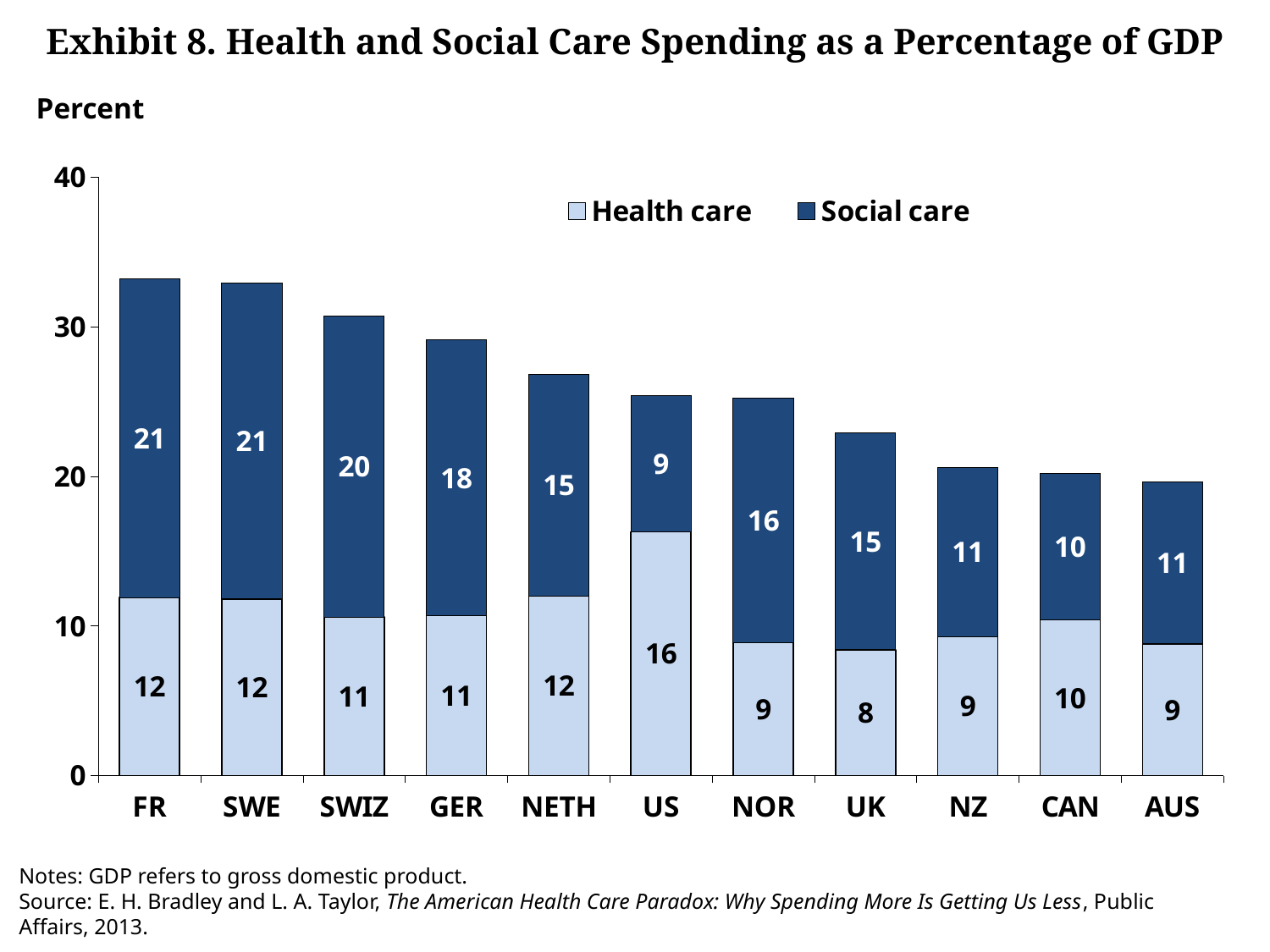
How many countries are shown on the x axis? 11 Is the total height of the SWIZ bar greater or less than 30? greater Which country has the lowest Health care value? UK Which country has the lowest Social care value? US What is the difference between the Social care values for FR and NOR? 5 What is the Social care value for GER? 18 Which country has the highest Health care value? US What is the Health care value for US? 16 What is the total of the stacked bar for UK? 23 What kind of chart is shown? Stacked bar chart Which has the larger Health care value, NETH or NOR? NETH How many series does the legend list? 2